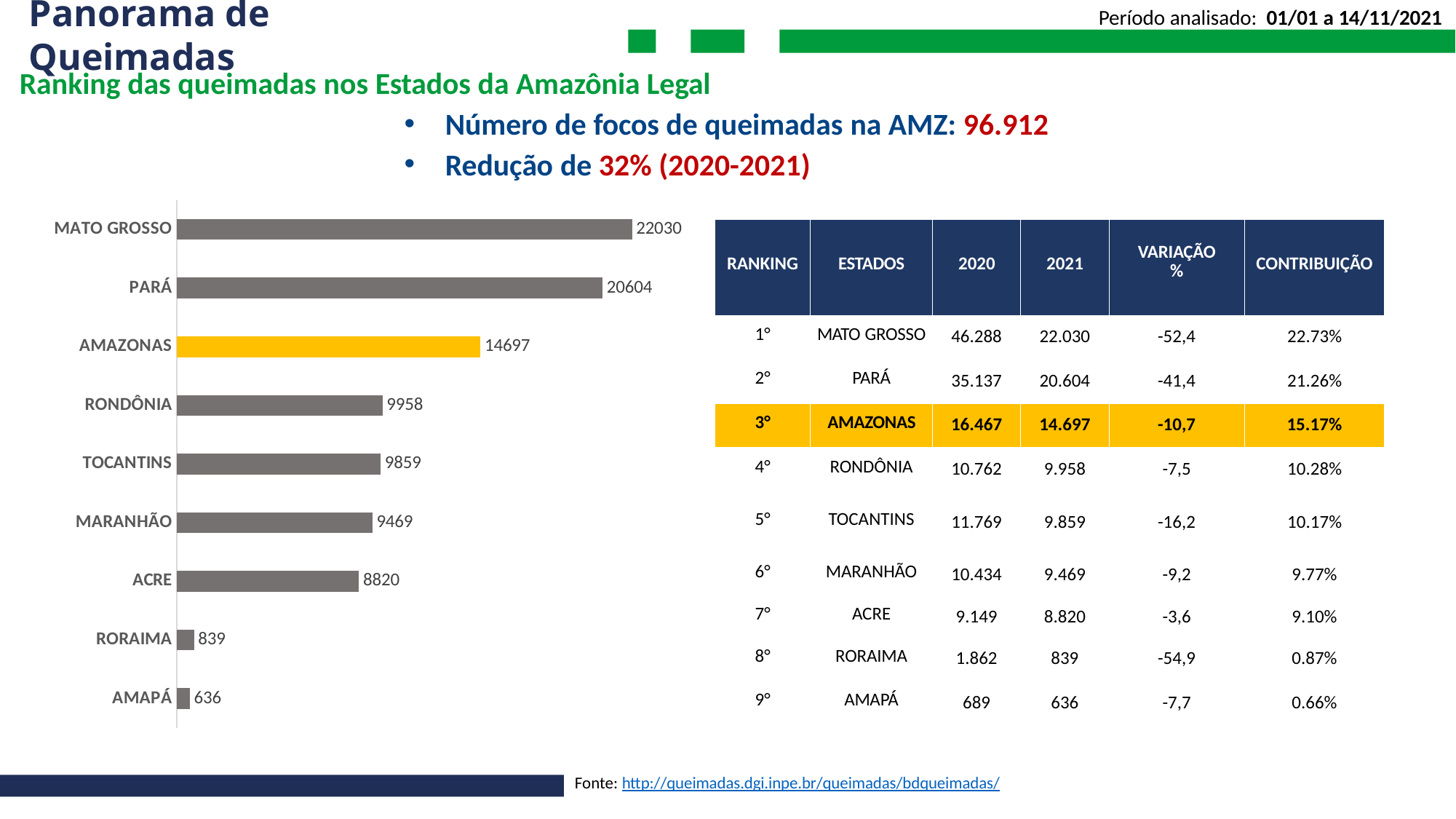
How many states are shown in the bar chart? 9 In the bar chart, which is larger, the value for MARANHÃO or the value for ACRE? MARANHÃO What is the value for AMAZONAS in the bar chart? 14697 What is the difference between the values for RORAIMA and AMAPÁ in the bar chart? 203 What is the value for MATO GROSSO in the bar chart? 22030 Which state has the lowest value in the bar chart? AMAPÁ What kind of chart is shown on the slide? Bar chart What is the value for RORAIMA in the bar chart? 839 Which state's bar is highlighted in a different colour (yellow) in the bar chart? AMAZONAS What is the difference between the values for MATO GROSSO and PARÁ in the bar chart? 1426 What is the value for ACRE in the bar chart? 8820 Which state has the highest value in the bar chart? MATO GROSSO